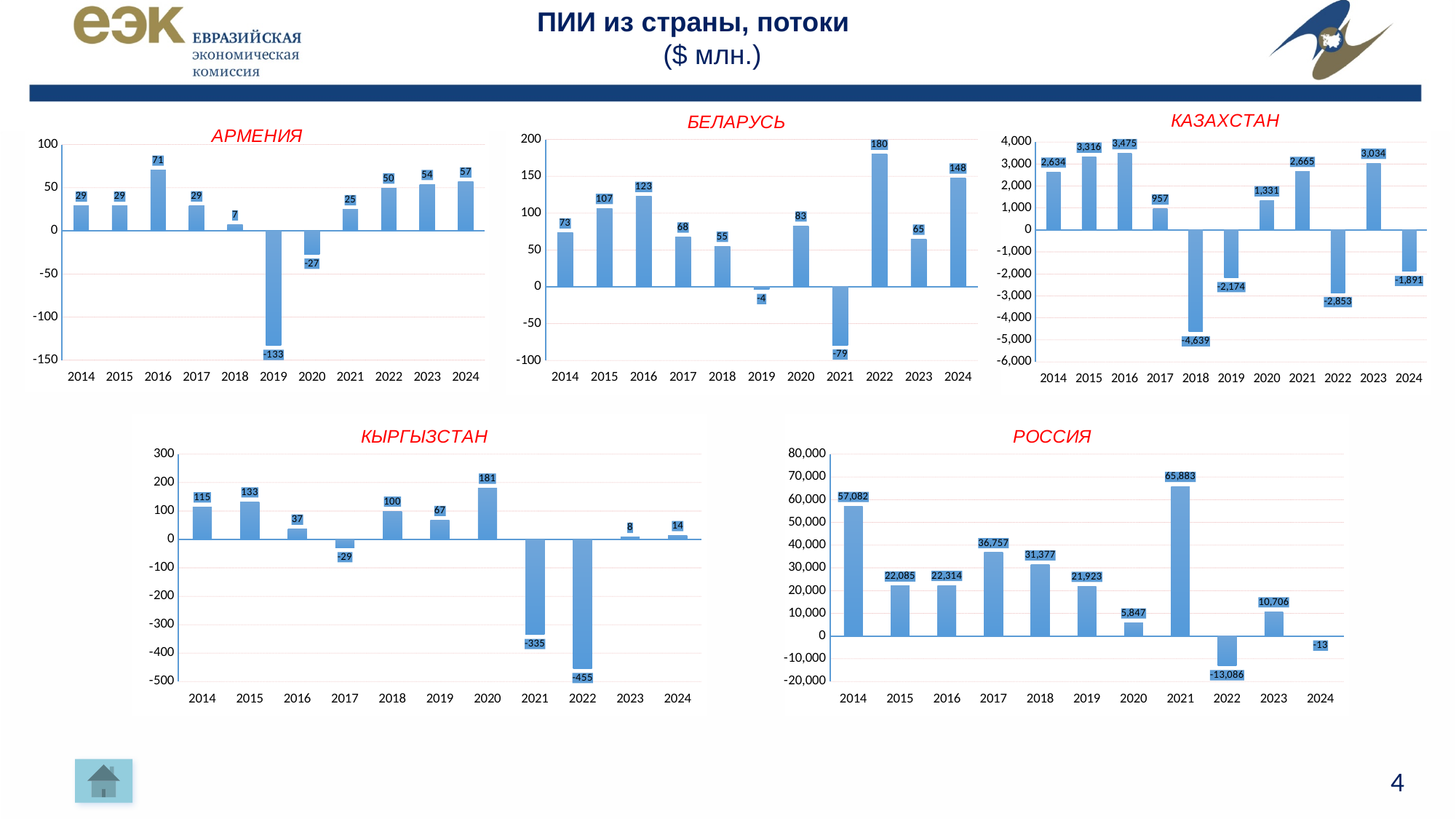
In the БЕЛАРУСЬ chart, what is the difference between the values for 2022 and 2024? 32 In the КЫРГЫЗСТАН chart, what is the value for 2020? 181 In the РОССИЯ chart, which is larger, the value for 2017 or the value for 2018? 2017 In the КАЗАХСТАН chart, what is the value for 2018? -4,639 In the РОССИЯ chart, what is the value for 2021? 65,883 In the АРМЕНИЯ chart, do the values rise or fall from 2021 to 2024? Rise How many years are shown on the x axis of the АРМЕНИЯ chart? 11 In the АРМЕНИЯ chart, what is the value for 2019? -133 In the БЕЛАРУСЬ chart, which year has the highest value? 2022 How many charts are shown on the slide? 5 In the КЫРГЫЗСТАН chart, which year has the lowest value? 2022 What kind of chart is the КАЗАХСТАН chart? Bar chart